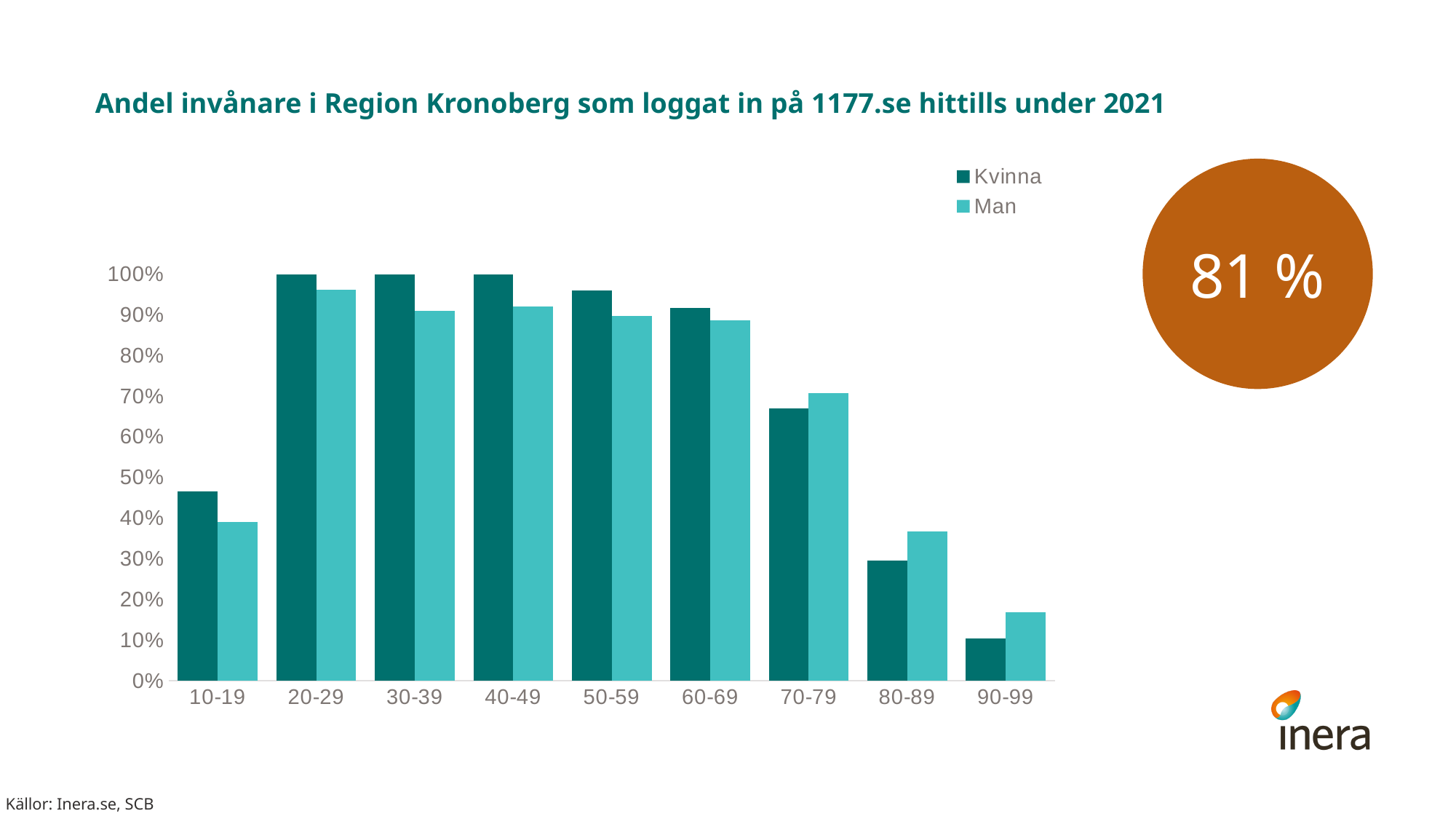
What kind of chart is shown on the slide? bar chart Which age group has the lowest value for Man? 90-99 In the 10-19 age group, which series has the larger value, Kvinna or Man? Kvinna What percentage is shown in the orange circle on the slide? 81 % Which age group has the lowest value for Kvinna? 90-99 In the 70-79 age group, which series has the larger value, Kvinna or Man? Man Is the value for Man in the 70-79 age group greater or less than 60%? greater How many series does the legend list? 2 How many age groups are shown on the x axis? 9 Is the value for Kvinna in the 80-89 age group greater or less than 40%? less